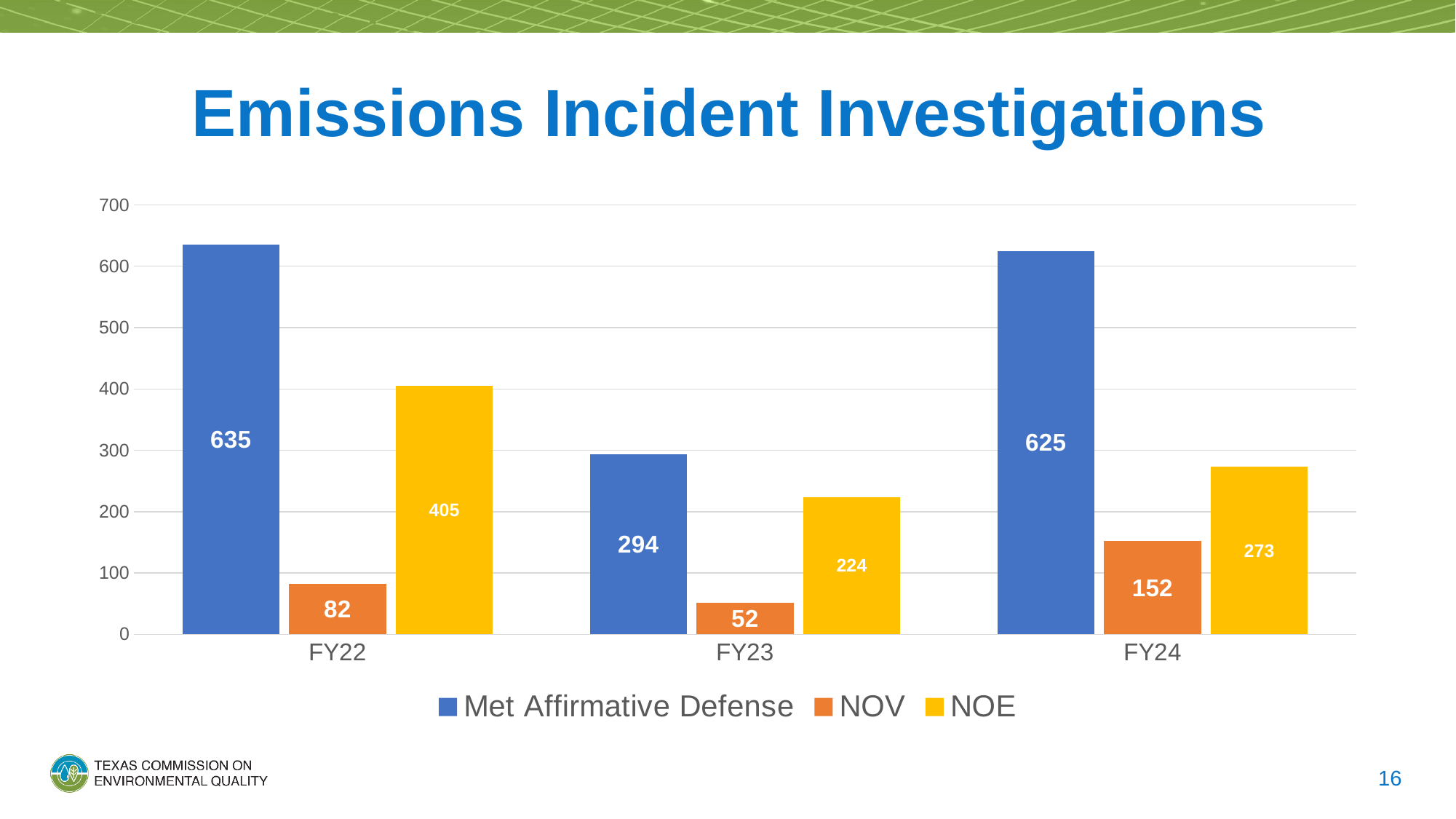
Which fiscal year has the lowest NOV value? FY23 What is the value for Met Affirmative Defense in FY22? 635 Which is larger in FY24, the NOV value or the NOE value? NOE How many fiscal years are shown on the x axis? 3 How many series does the legend list? 3 What kind of chart is shown on the slide? Bar chart Is the Met Affirmative Defense value for FY23 greater or less than 300? less What is the difference between the NOE values for FY22 and FY23? 181 What is the difference between the NOV values for FY24 and FY22? 70 What is the NOV value in FY23? 52 Which fiscal year has the highest Met Affirmative Defense value? FY22 What is the NOE value in FY24? 273